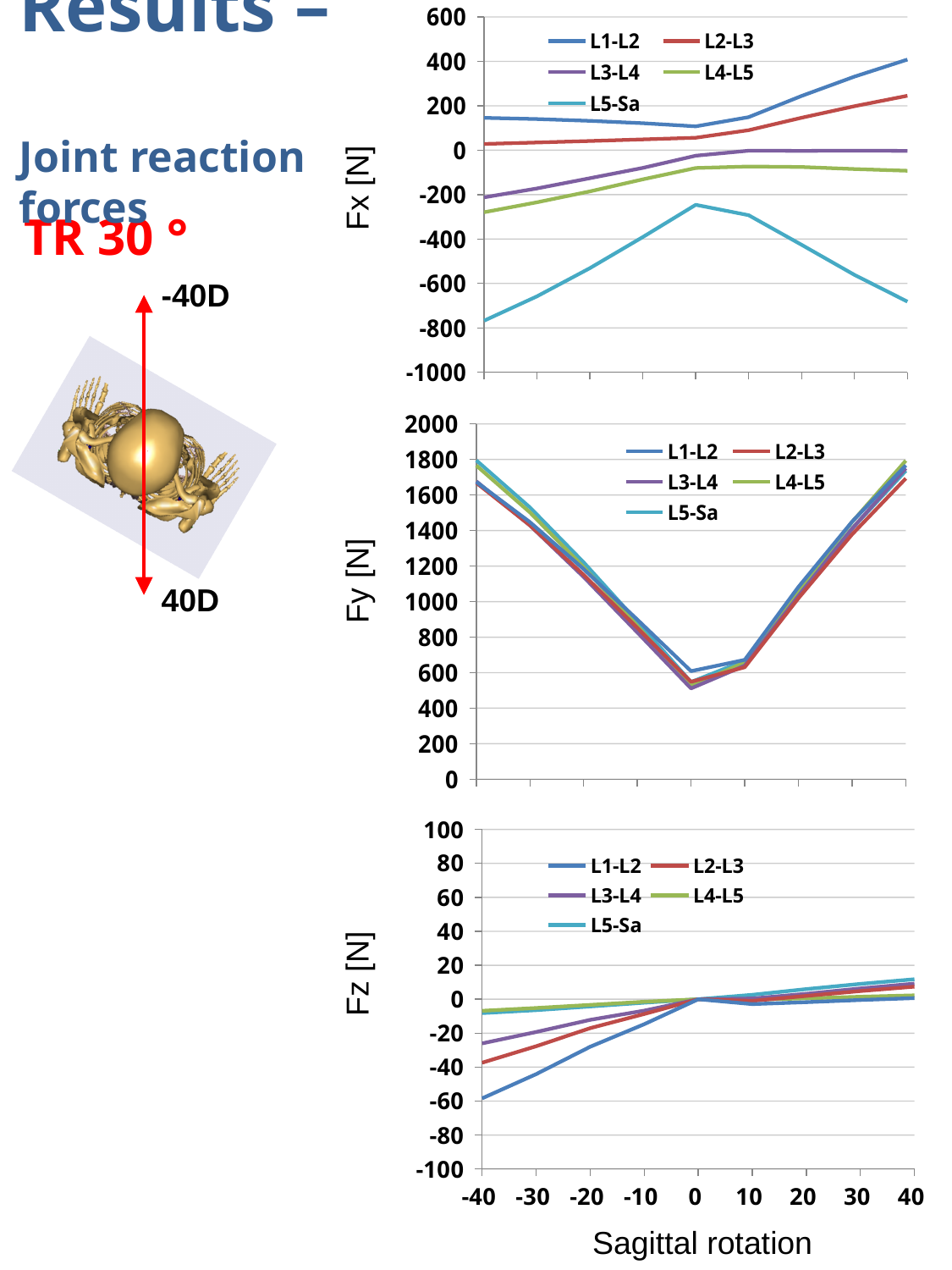
In the Fy [N] chart, is the value for L5-Sa at a sagittal rotation of -40 greater or less than 1600? greater In the Fx [N] chart, which is larger at a sagittal rotation of -40: L2-L3 or L3-L4? L2-L3 In the Fx [N] chart, is the value for L1-L2 at a sagittal rotation of 40 greater or less than 200? greater What is the x-axis label shared by the three charts? Sagittal rotation In the Fy [N] chart, how do the values change as sagittal rotation goes from -40 to 40? They fall to a minimum near 0 and then rise In the Fx [N] chart, is the value for L5-Sa at a sagittal rotation of -40 greater or less than -600? less In the Fz [N] chart, which series has the lowest value at a sagittal rotation of -40? L1-L2 How many series does the legend of the Fy [N] chart list? 5 In the Fx [N] chart, which series has the highest value at a sagittal rotation of 40? L1-L2 What kind of chart is the Fx [N] chart at the top of the slide? line chart In the Fx [N] chart, which series has the lowest values across the whole range of sagittal rotation? L5-Sa